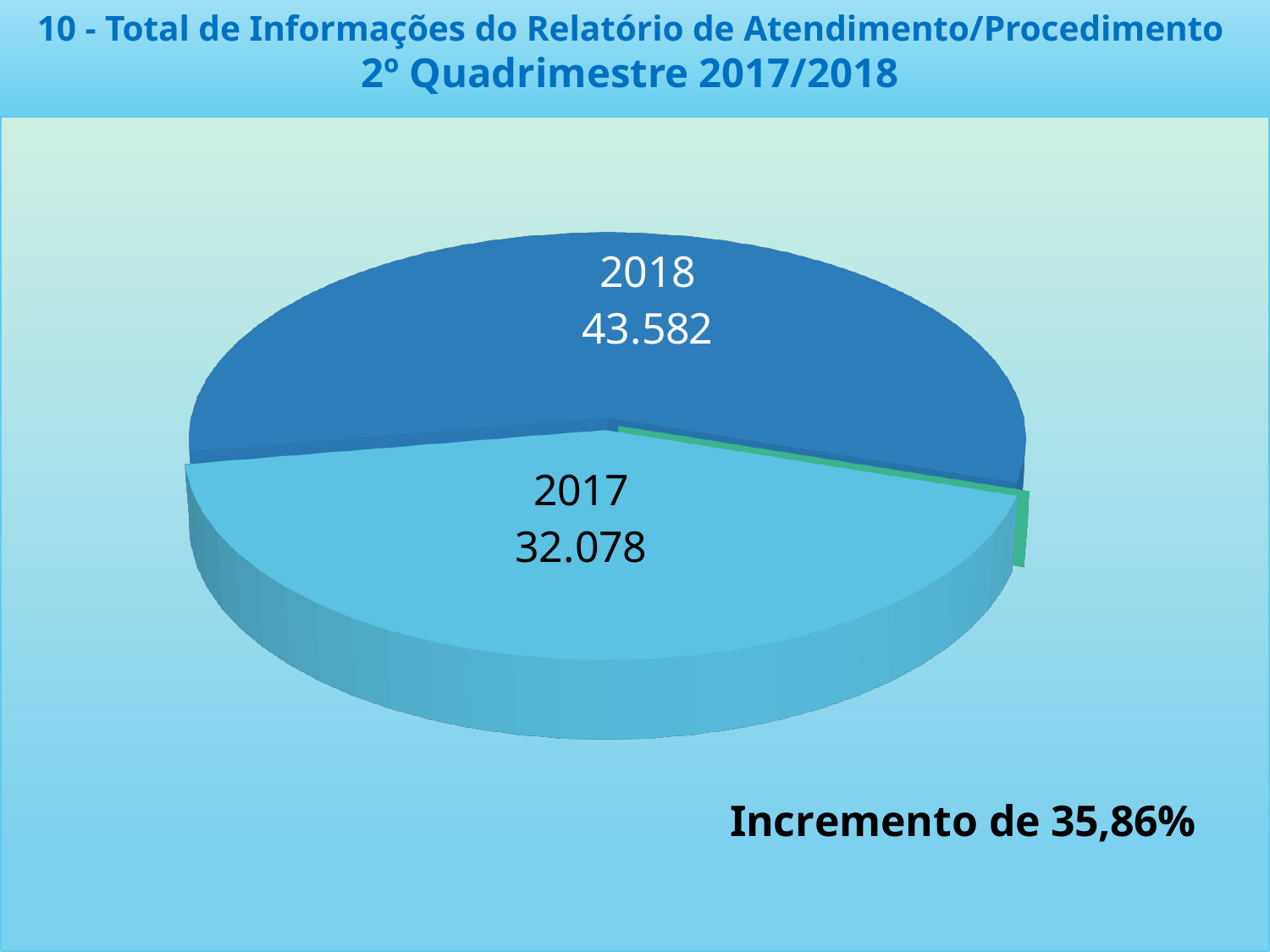
What is the value for 2017 in the pie chart? 32.078 What share of the pie does the 2018 slice represent, to one decimal place? 57.6% What kind of chart is shown on the slide? Pie chart What is the difference between the 2018 value and the 2017 value? 11.504 Which year has the larger slice in the pie chart? 2018 What is the value for 2018 in the pie chart? 43.582 Which year has the smaller slice in the pie chart? 2017 How many slices does the pie chart have? 2 Which period does the chart title say the data covers? 2º Quadrimestre 2017/2018 Is the value for 2018 larger or smaller than the value for 2017? Larger What percentage increase is stated on the slide below the chart? 35,86% What is the combined total of the two slices in the pie chart? 75.660